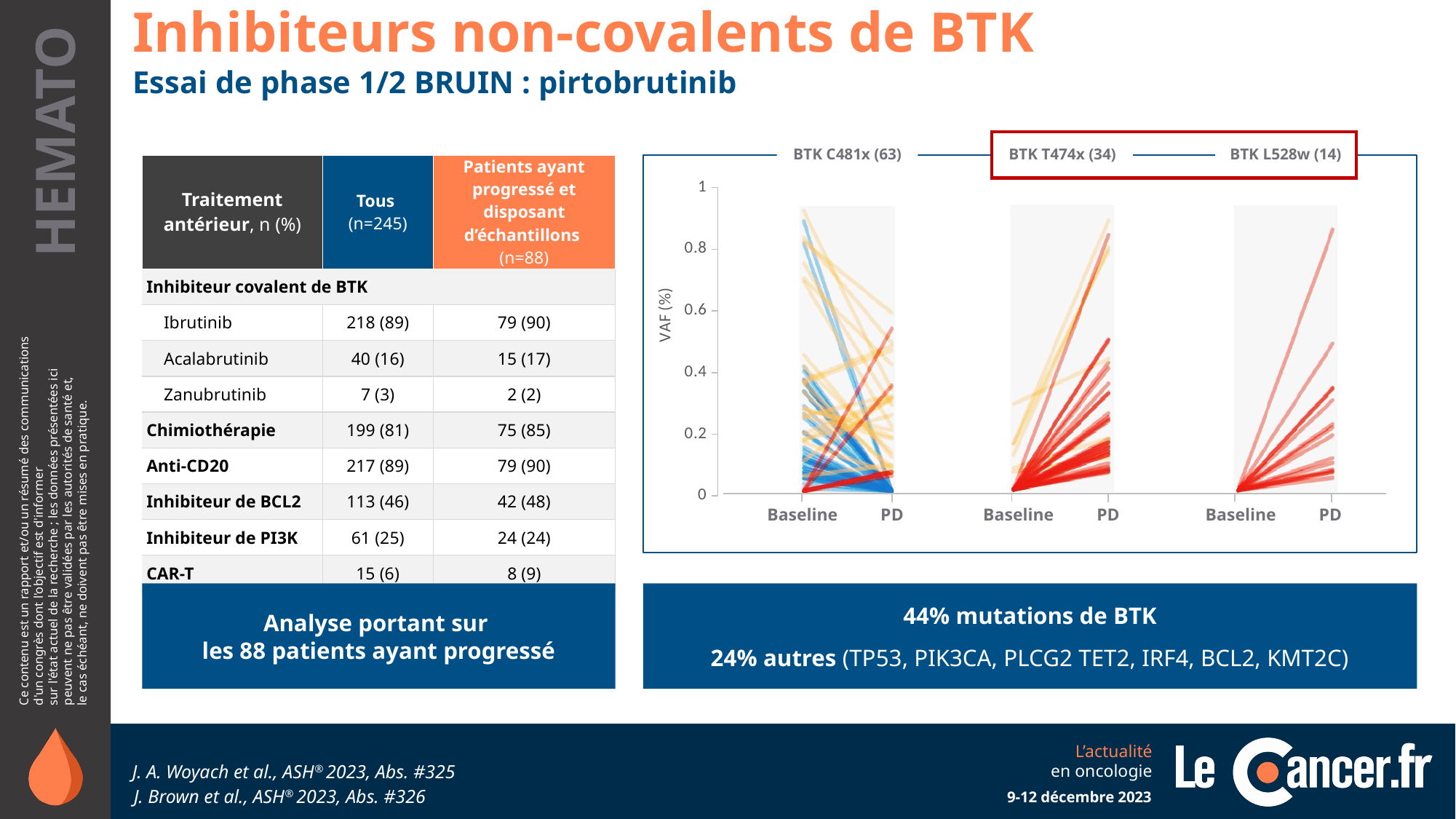
How many patients are indicated in the title of the BTK C481x panel? 63 What is the label of the y axis of the chart? VAF (%) In the BTK L528w panel, are the VAF values at Baseline greater or less than 0.2? less In the BTK L528w panel, do the VAF values rise or fall from Baseline to PD? rise Which panel of the chart has the smallest number of patients in its title? BTK L528w (14) What are the two x-axis categories in each panel of the chart? Baseline and PD In the BTK C481x panel, do most VAF values rise or fall from Baseline to PD? fall In the BTK L528w panel, is the highest VAF value at PD greater or less than 0.6? greater Which panel of the chart has the largest number of patients in its title? BTK C481x (63) How many panels (mutation groups) does the chart on the right contain? 3 How many patients are indicated in the title of the BTK L528w panel? 14 What kind of chart is shown on the right of the slide? line chart